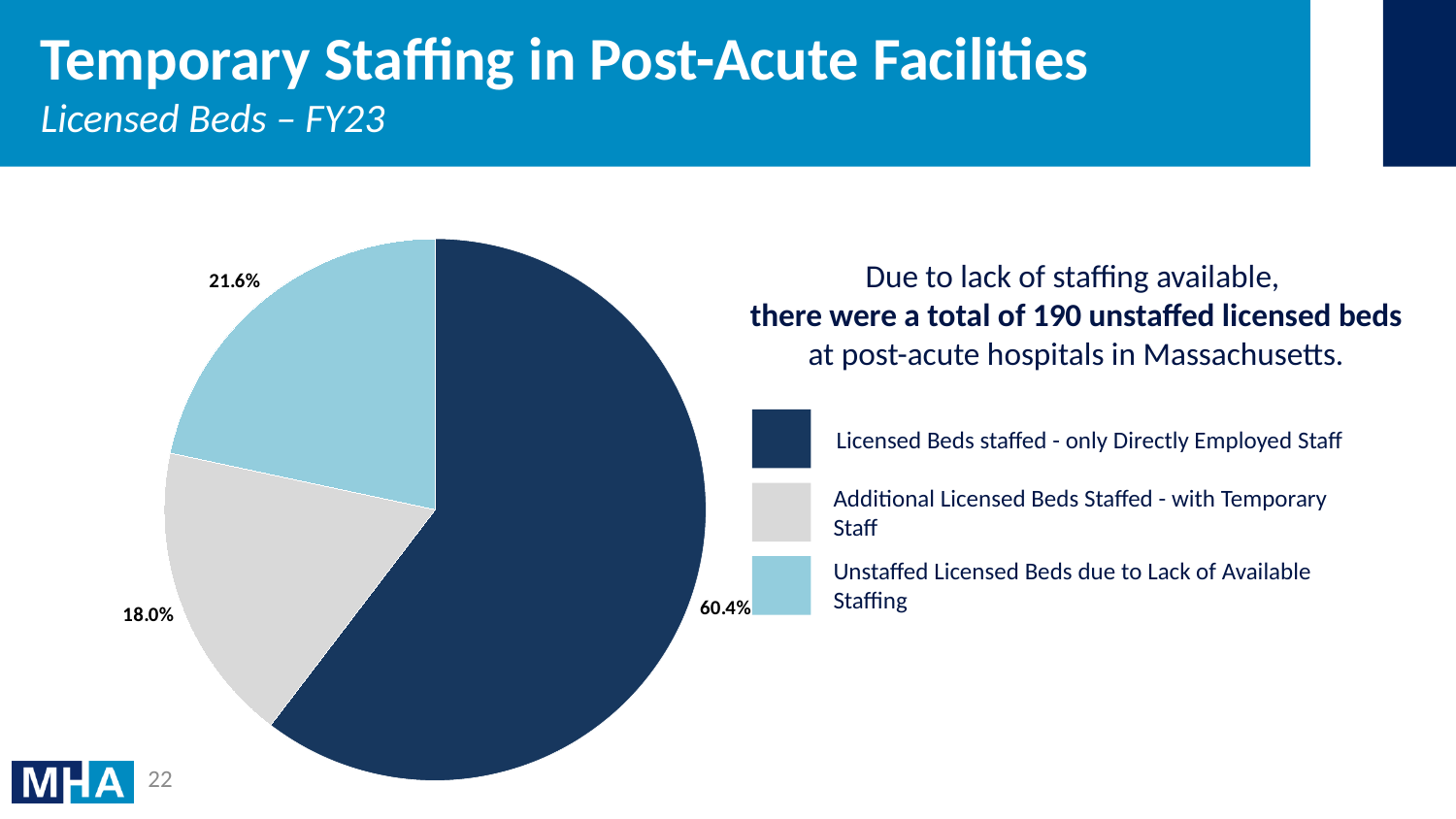
How many slices does the pie chart have? 3 What share of licensed beds is unstaffed due to lack of available staffing? 21.6% What share of licensed beds is staffed only by directly employed staff? 60.4% How many entries does the legend list? 3 What kind of chart is shown on the slide? pie chart Which is larger: the share of unstaffed licensed beds or the share of additional beds staffed with temporary staff? Unstaffed Licensed Beds due to Lack of Available Staffing What colour is the slice for unstaffed licensed beds due to lack of available staffing? light blue What is the subtitle of the slide? Licensed Beds – FY23 What is the difference in percentage points between the directly employed staff slice and the unstaffed beds slice? 38.8 Which category has the smallest slice of the pie? Additional Licensed Beds Staffed - with Temporary Staff Which category has the largest slice of the pie? Licensed Beds staffed - only Directly Employed Staff What share of licensed beds is additional beds staffed with temporary staff? 18.0%